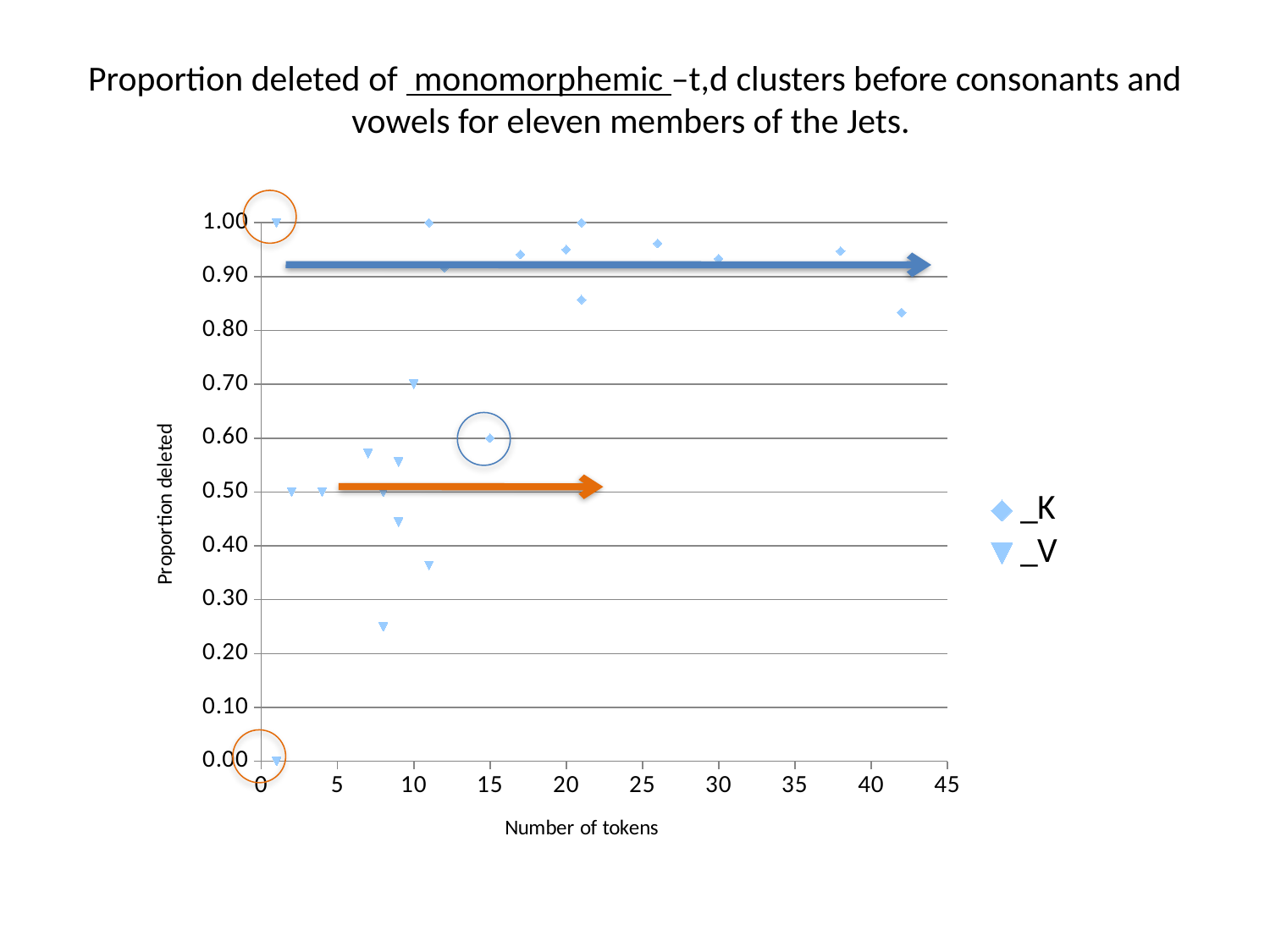
Is the _K point with the most tokens (around 42) greater or less than 0.90? less Is the _V point at 10 tokens greater or less than 0.60? greater What are the two series names shown in the legend? _K and _V What is the title of the vertical axis? Proportion deleted Is the _K point at 30 tokens greater or less than 0.90? greater What kind of chart is shown on the slide? scatter chart Which series generally has higher proportion deleted values, _K or _V? _K What proportion deleted value does the circled _K point at 15 tokens sit on? 0.60 Which series contains the lowest plotted point on the chart? _V How many series does the legend list? 2